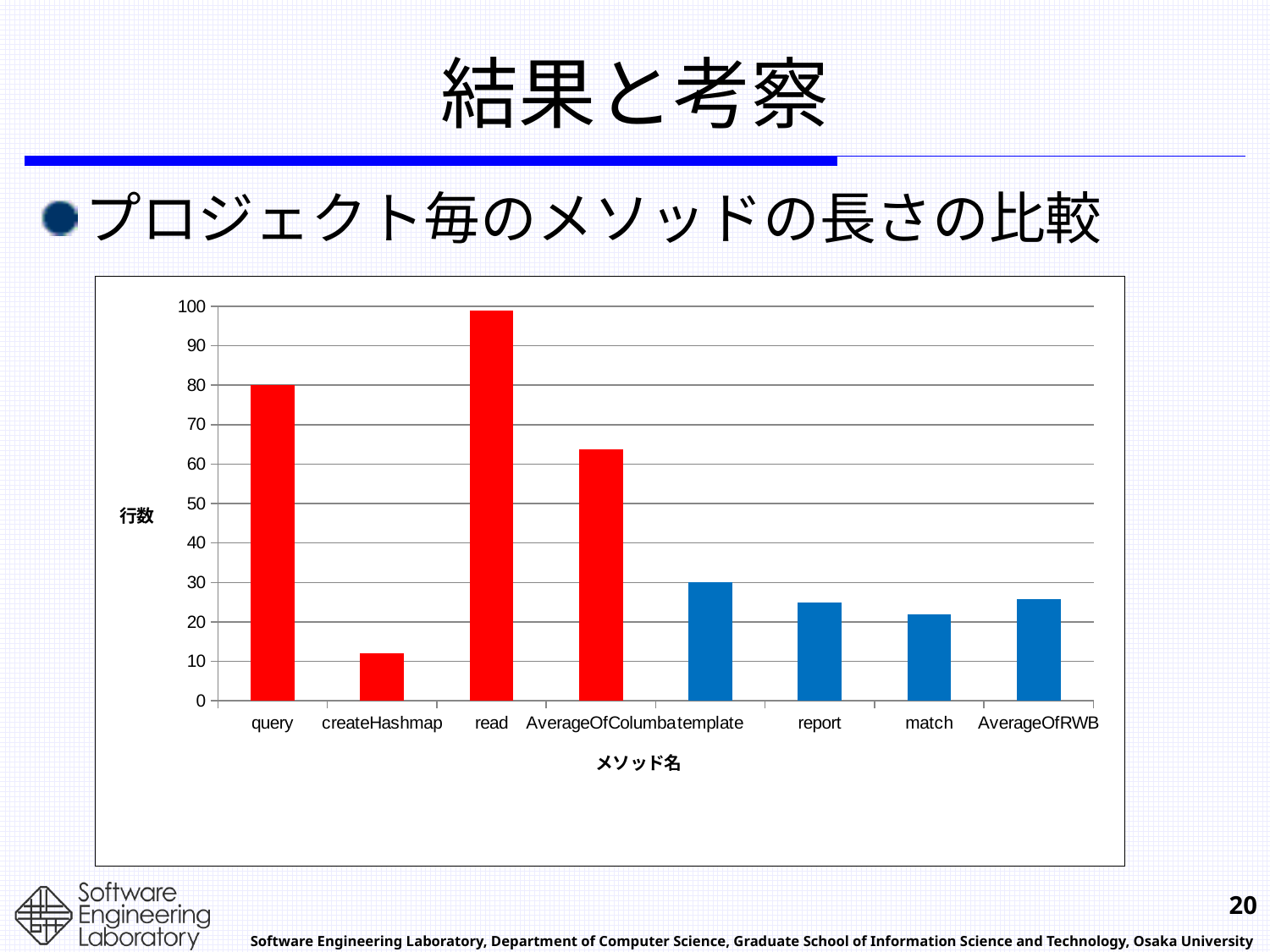
Is the value for match greater or less than 30? less Is the value for createHashmap greater or less than 20? less Which has a larger value, AverageOfColumba or AverageOfRWB? AverageOfColumba Is the value for AverageOfColumba greater or less than 60? greater Which method has the lowest value in the chart? createHashmap What is the label of the vertical axis of the chart? 行数 Which method has the highest value in the chart? read Which has a larger value, query or read? read What kind of chart is shown on the slide? bar chart How many method categories are shown on the x axis of the chart? 8 Which has a larger value, template or match? template